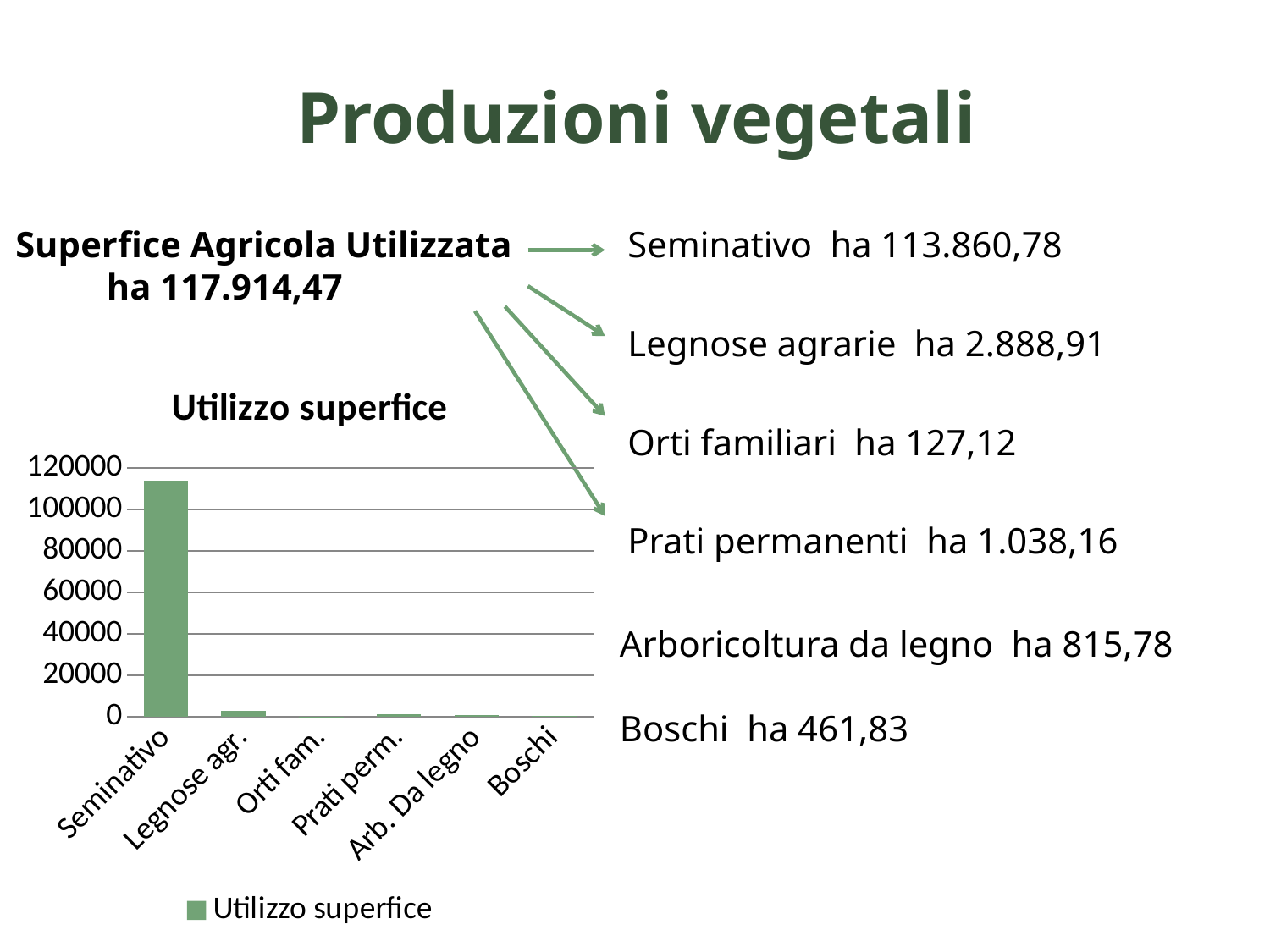
Which category has the highest value in the chart? Seminativo How many series does the chart legend list? 1 What is the label of the first category on the x axis? Seminativo Is the value for Seminativo greater or less than 100000? greater Is the value for Boschi greater or less than 20000? less Which is larger, the value for Legnose agr. or the value for Orti fam.? Legnose agr. Which is larger, the value for Seminativo or the value for Legnose agr.? Seminativo Is the value for Legnose agr. greater or less than 20000? less What is the highest value shown on the y axis of the chart? 120000 What type of chart is shown on the slide? bar chart What is the title of the chart? Utilizzo superfice How many categories are shown on the x axis of the chart? 6